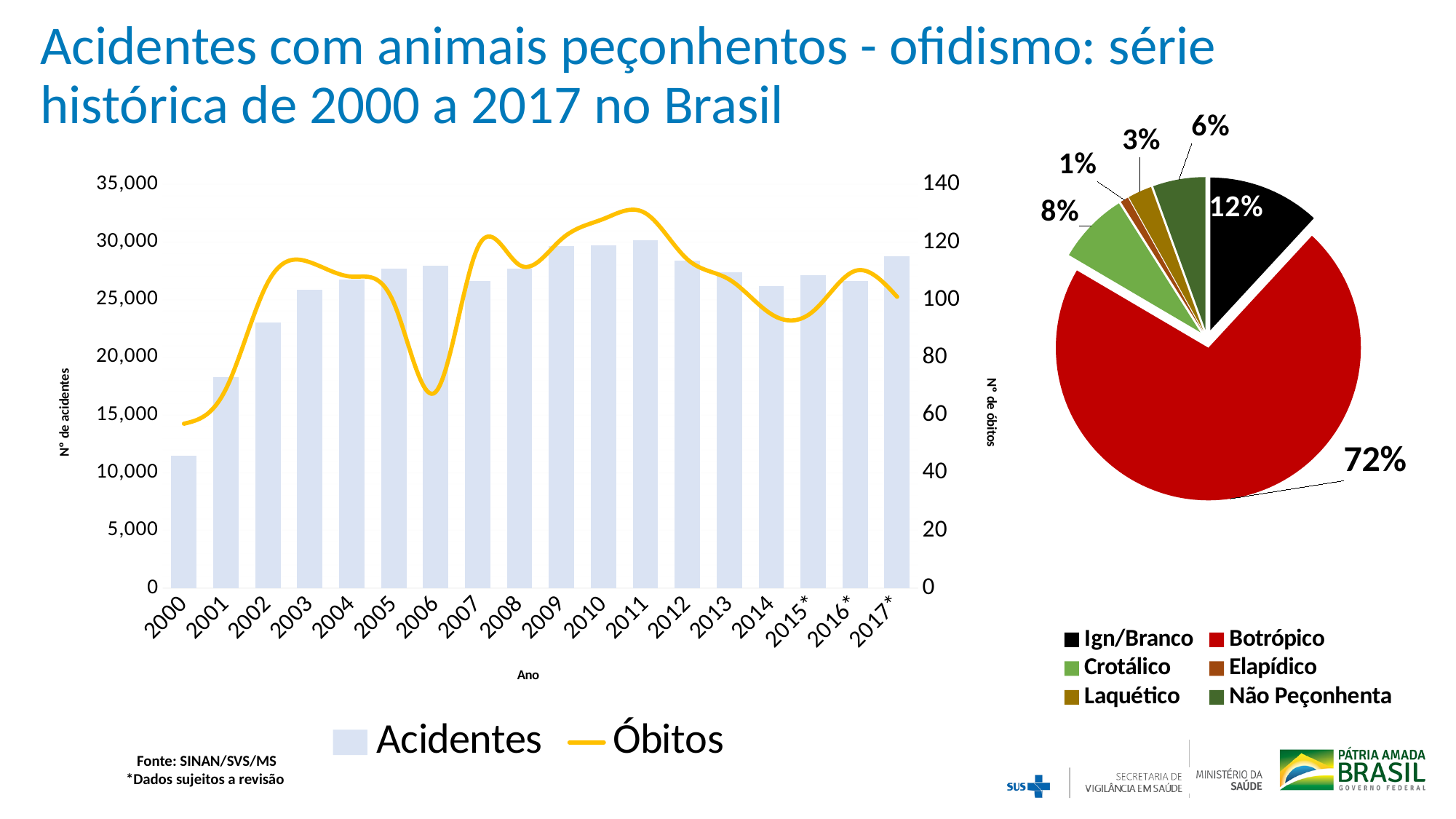
In the pie chart on the right, what share does Crotálico have? 8% In the pie chart on the right, what is the difference between the shares of Ign/Branco and Não Peçonhenta? 6% In the pie chart on the right, what share does Laquético have? 3% In the chart on the left, is the number of Acidentes in 2000 greater or less than 15,000? less In the pie chart on the right, which category has the smallest slice? Elapídico In the chart on the left, is the number of Acidentes in 2011 greater or less than 25,000? greater In the chart on the left, how many years are shown on the x axis? 18 In the pie chart on the right, which category has the largest slice? Botrópico In the chart on the left, how many series does the legend list? 2 In the chart on the left, which year has the lowest number of Acidentes? 2000 In the pie chart on the right, how many categories does the legend list? 6 In the pie chart on the right, what share does Botrópico have? 72%